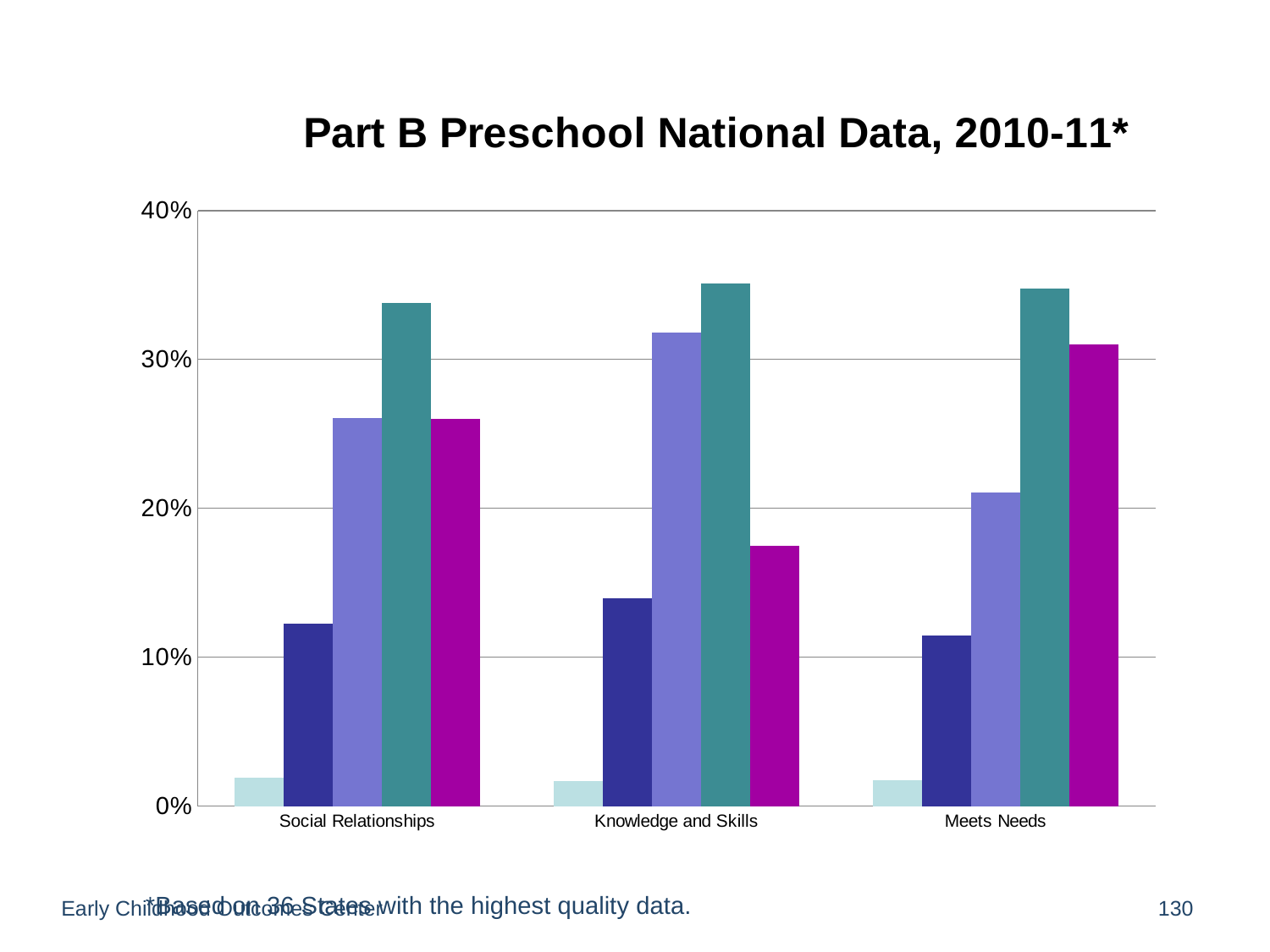
What is the title of the chart? Part B Preschool National Data, 2010-11* Which bar is the shortest in the Meets Needs group? the light blue (first) bar Is the value of the magenta (fifth) bar for Knowledge and Skills greater or less than 20%? less How many categories are shown on the x axis of the chart? 3 How many bars are plotted for each category in the chart? 5 Is the value of the purple (third) bar for Meets Needs greater or less than 30%? less What kind of chart is shown on the slide? bar chart Is the value of the dark blue (second) bar for Social Relationships greater or less than 10%? greater In the Knowledge and Skills group, which is larger: the purple (third) bar or the magenta (fifth) bar? the purple (third) bar In the Meets Needs group, which is larger: the purple (third) bar or the magenta (fifth) bar? the magenta (fifth) bar Which bar is the tallest in the Knowledge and Skills group? the teal (fourth) bar